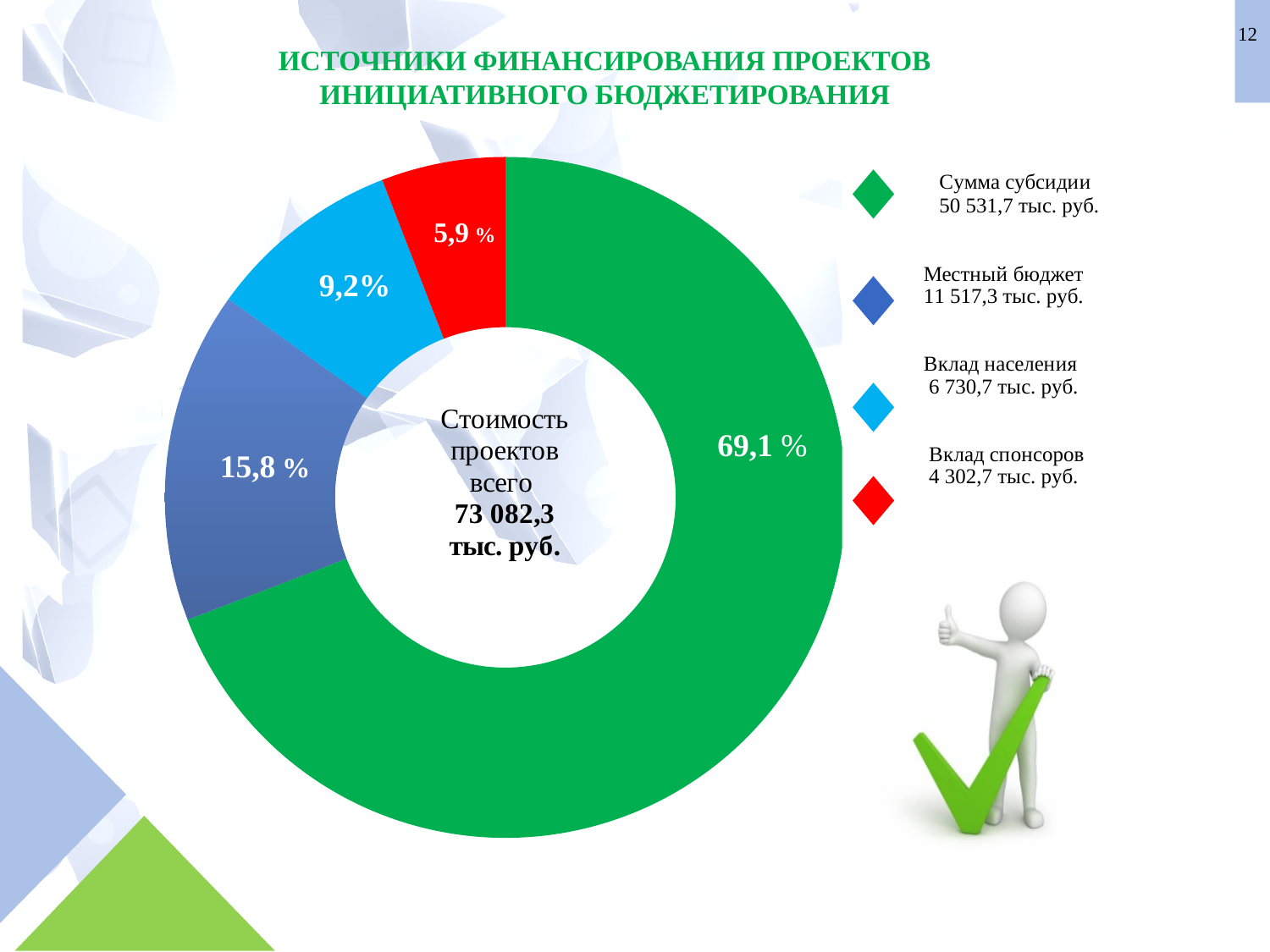
Which funding source has the smallest share of the chart? Вклад спонсоров How many slices does the chart have? 4 Which funding source has the largest share of the chart? Сумма субсидии Which is larger, the share for Местный бюджет or the share for Вклад населения? Местный бюджет What percentage is shown for the Вклад населения slice? 9,2% What percentage is shown for the Вклад спонсоров slice? 5,9 % What amount is listed in the legend for Вклад спонсоров? 4 302,7 тыс. руб. What percentage is shown for the Местный бюджет slice? 15,8 % What kind of chart is shown on the slide? Pie (donut) chart What share of the chart does Сумма субсидии (green slice) take? 69,1 % What total project cost is shown in the centre of the chart? 73 082,3 тыс. руб. What amount is listed in the legend for Сумма субсидии? 50 531,7 тыс. руб.